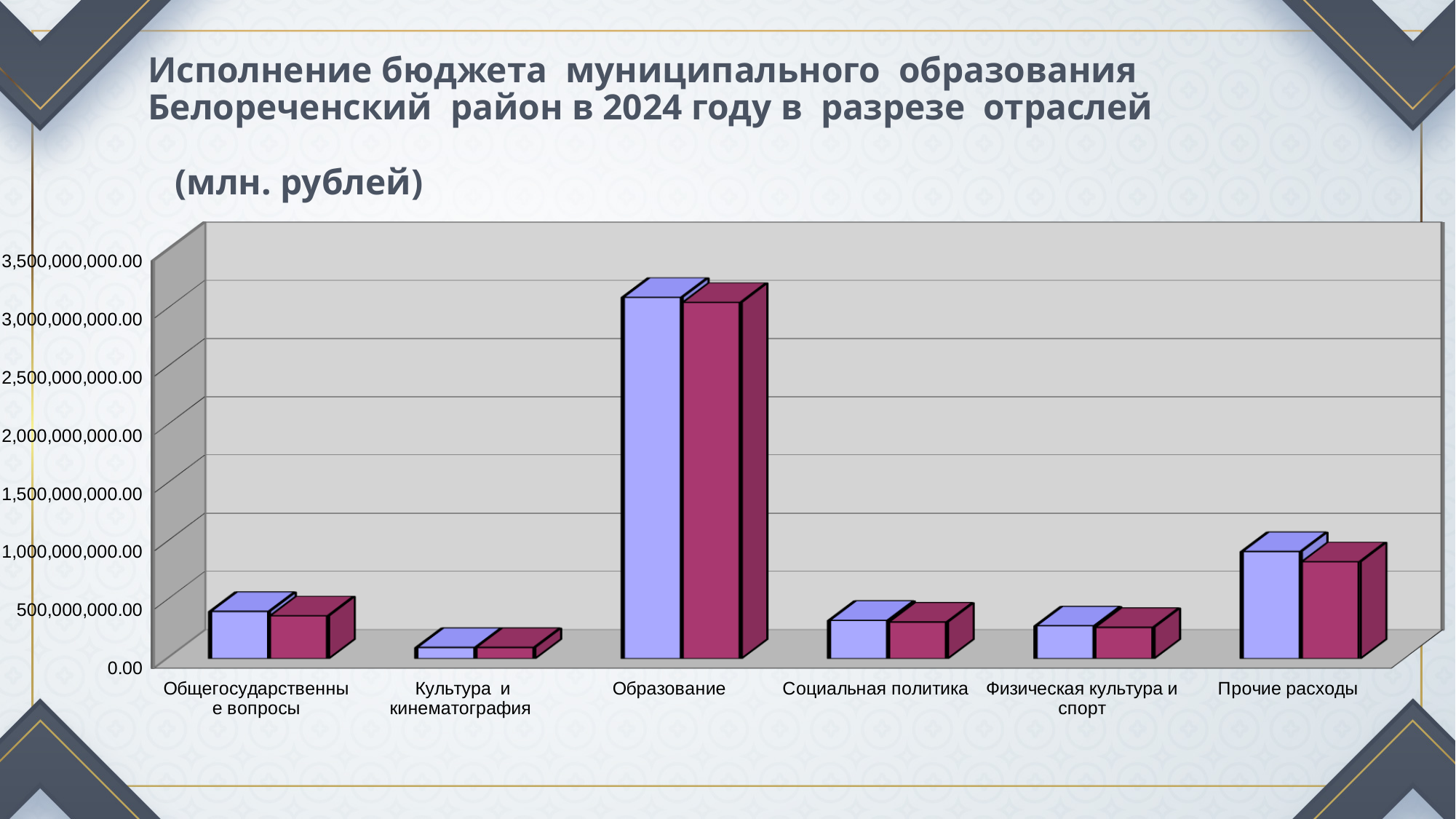
What kind of chart is shown on the slide? Bar chart How many categories are shown on the x axis of the chart? 6 Which category has a larger blue bar: Общегосударственные вопросы or Культура и кинематография? Общегосударственные вопросы Is the value of the blue bar for Образование greater or less than 3,000,000,000.00? greater What is the highest value shown on the vertical axis of the chart? 3,500,000,000.00 Which category has the lowest bars in the chart? Культура и кинематография Which category has a larger blue bar: Прочие расходы or Социальная политика? Прочие расходы Which category has the highest bars in the chart? Образование In what units does the slide say the budget figures are given? млн. рублей Is the value of the blue bar for Культура и кинематография greater or less than 500,000,000.00? less Is the value of the blue bar for Социальная политика greater or less than 500,000,000.00? less